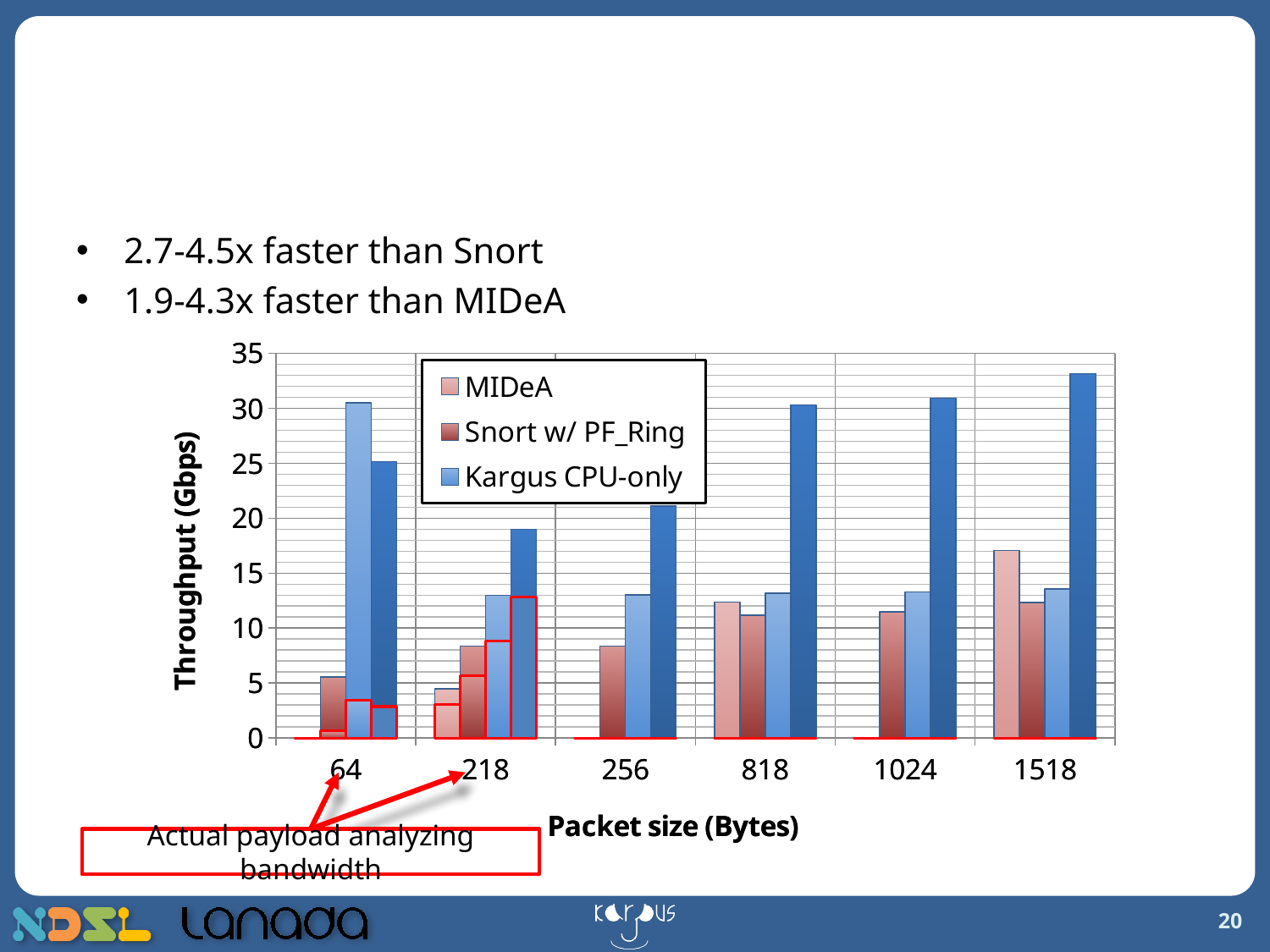
What is the title of the y axis? Throughput (Gbps) Is the Kargus CPU-only value at packet size 64 greater or less than 25? greater What kind of chart is shown on the slide? bar chart At packet size 1518, which is larger: MIDeA or Snort w/ PF_Ring? MIDeA Is the Snort w/ PF_Ring value at packet size 64 greater or less than 10? less Is the MIDeA value at packet size 1518 greater or less than 15? greater How many series does the chart's legend list? 3 At which packet size is the MIDeA throughput highest? 1518 At which packet size is the Kargus CPU-only throughput highest? 64 At packet size 218, which is larger: MIDeA or Snort w/ PF_Ring? Snort w/ PF_Ring How many packet size categories are shown on the x axis? 6